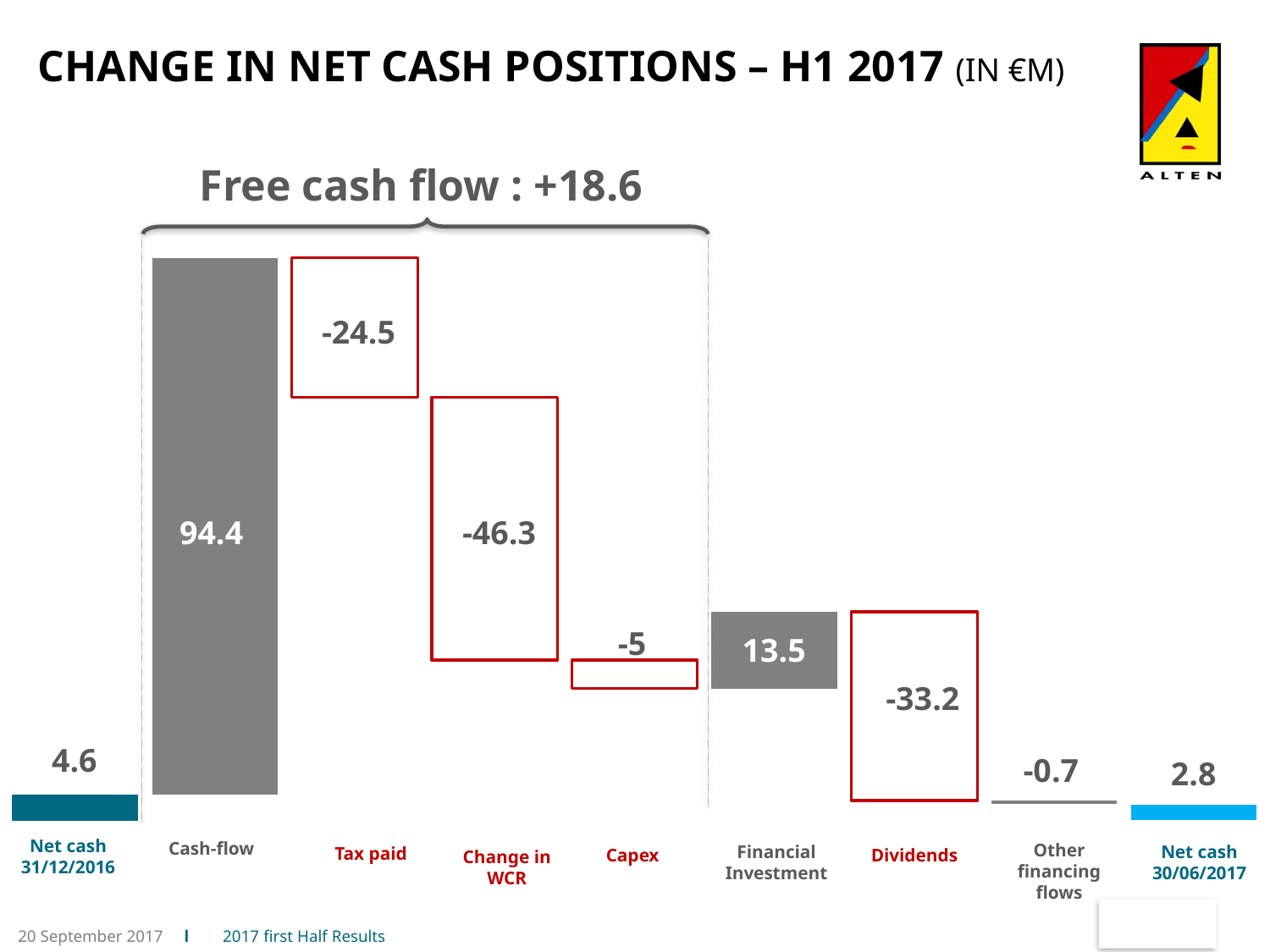
Which is larger in magnitude, Tax paid or Dividends? Dividends Which category has the largest positive value? Cash-flow What is the Net cash at 30/06/2017? 2.8 What free cash flow figure is shown above the bracket on the chart? +18.6 How many categories are shown along the x axis? 9 What is the value for Dividends? -33.2 What is the value for Cash-flow? 94.4 Which category has the most negative value? Change in WCR What is the value for Tax paid? -24.5 What is the value for Change in WCR? -46.3 What is the difference between Net cash at 31/12/2016 and Net cash at 30/06/2017? 1.8 What is the value for Financial Investment? 13.5